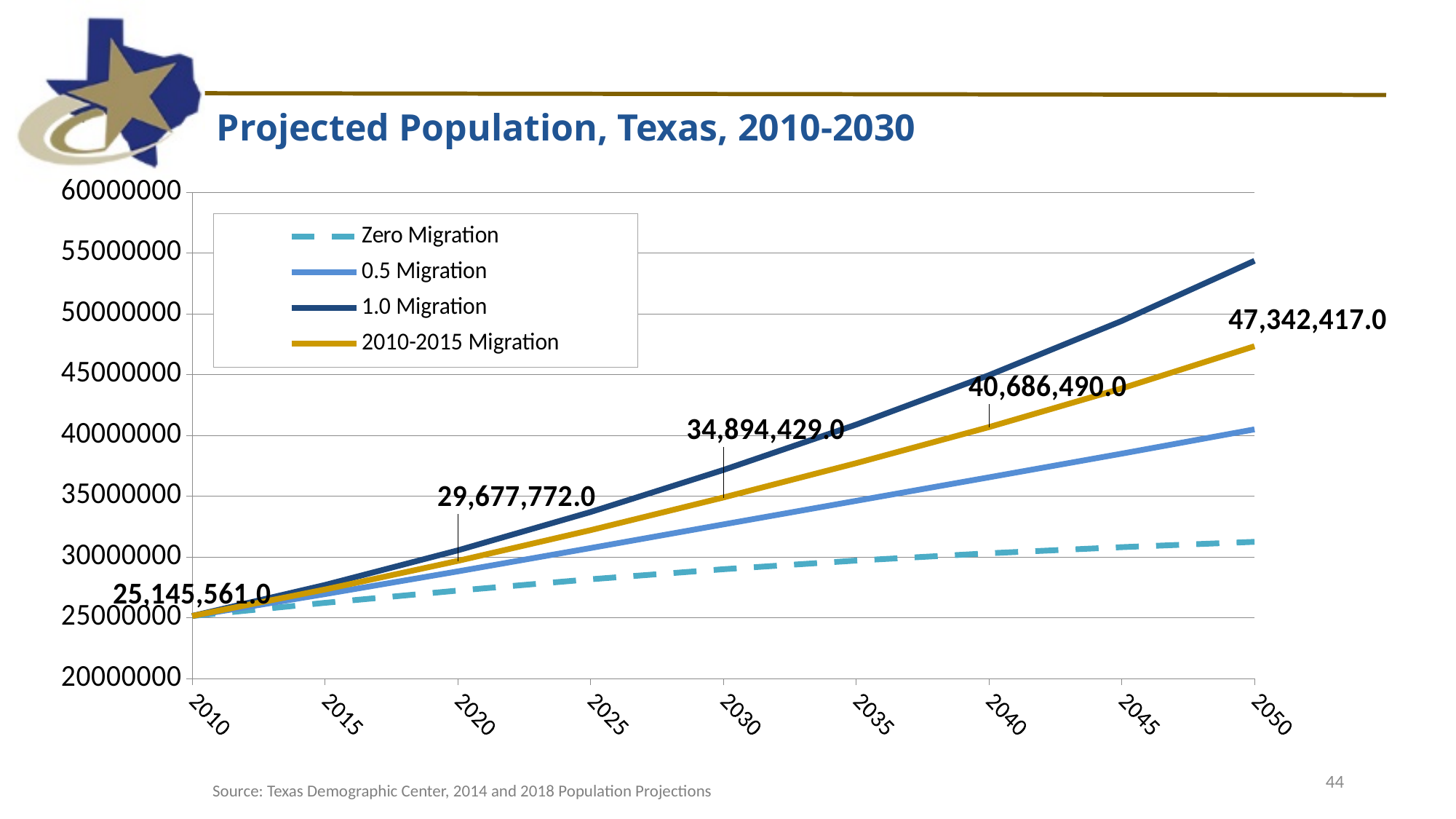
What is the value of the 2010-2015 Migration series in 2020? 29,677,772.0 How many series does the legend list? 4 What is the value of the 2010-2015 Migration series in 2050? 47,342,417.0 Is the value for Zero Migration in 2050 greater or less than 35000000? less Is the value for 1.0 Migration in 2050 greater or less than 50000000? greater Which series is drawn with a dashed line? Zero Migration Which series has the lowest value in 2050? Zero Migration Which series has the highest value in 2050? 1.0 Migration What type of chart is shown on the slide? line chart By how much does the 2010-2015 Migration series increase from 2010 to 2050? 22,196,856.0 What is the value of the 2010-2015 Migration series in 2010? 25,145,561.0 What is the value of the 2010-2015 Migration series in 2040? 40,686,490.0